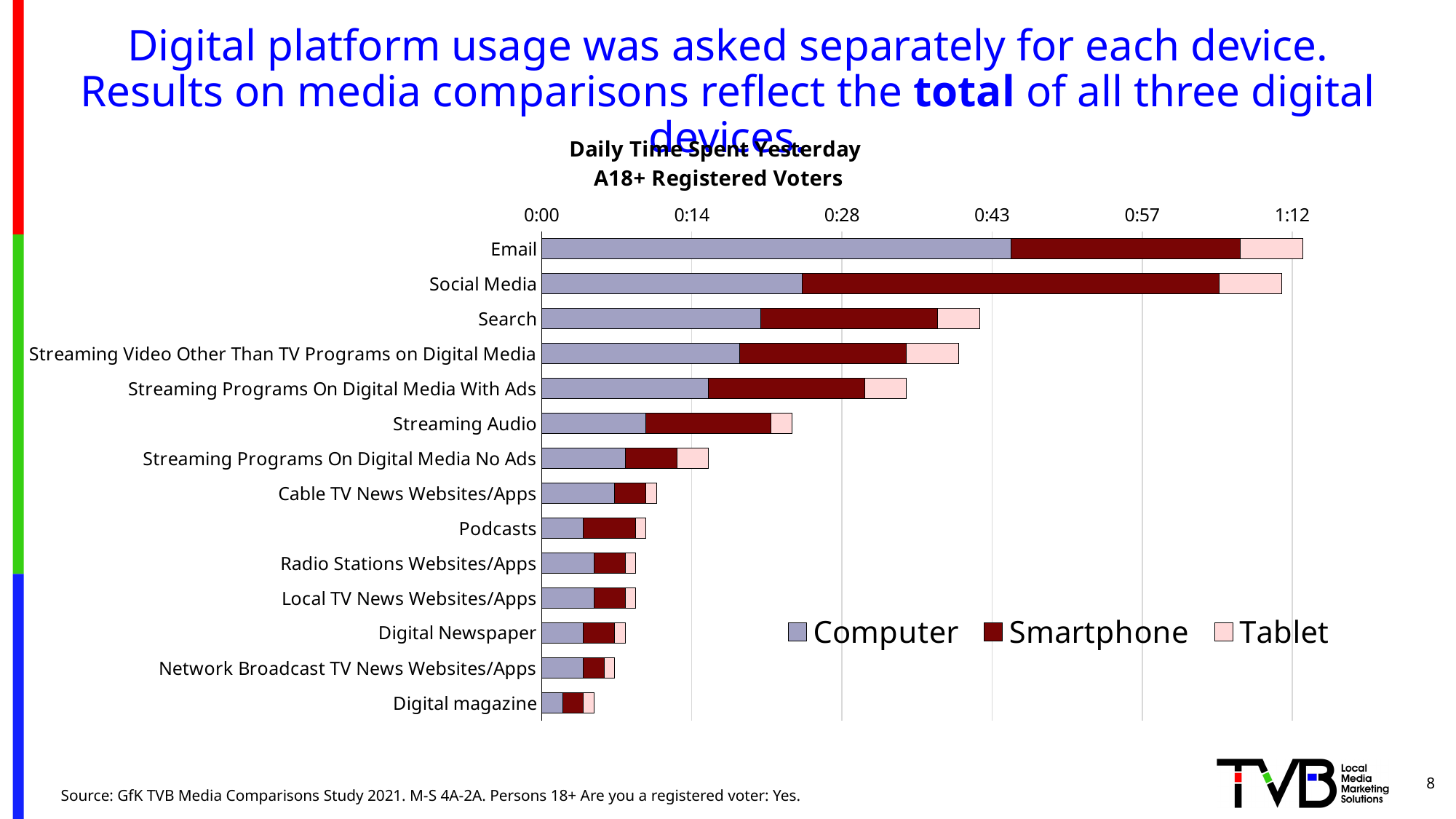
How many categories (platforms) are plotted in the chart? 14 Is the total daily time for Podcasts greater or less than 0:14? less Is the total daily time for Streaming Audio greater or less than 0:28? less Which has the larger Smartphone segment, Email or Social Media? Social Media Is the total daily time for Search greater or less than 0:28? greater What is the title of the chart? Daily Time Spent Yesterday A18+ Registered Voters Which series is shown in the dark red colour in the legend? Smartphone Which platform has the shortest total bar? Digital magazine What kind of chart is shown on the slide? Stacked bar chart How many series does the legend list? 3 Which has the larger total bar, Search or Streaming Audio? Search